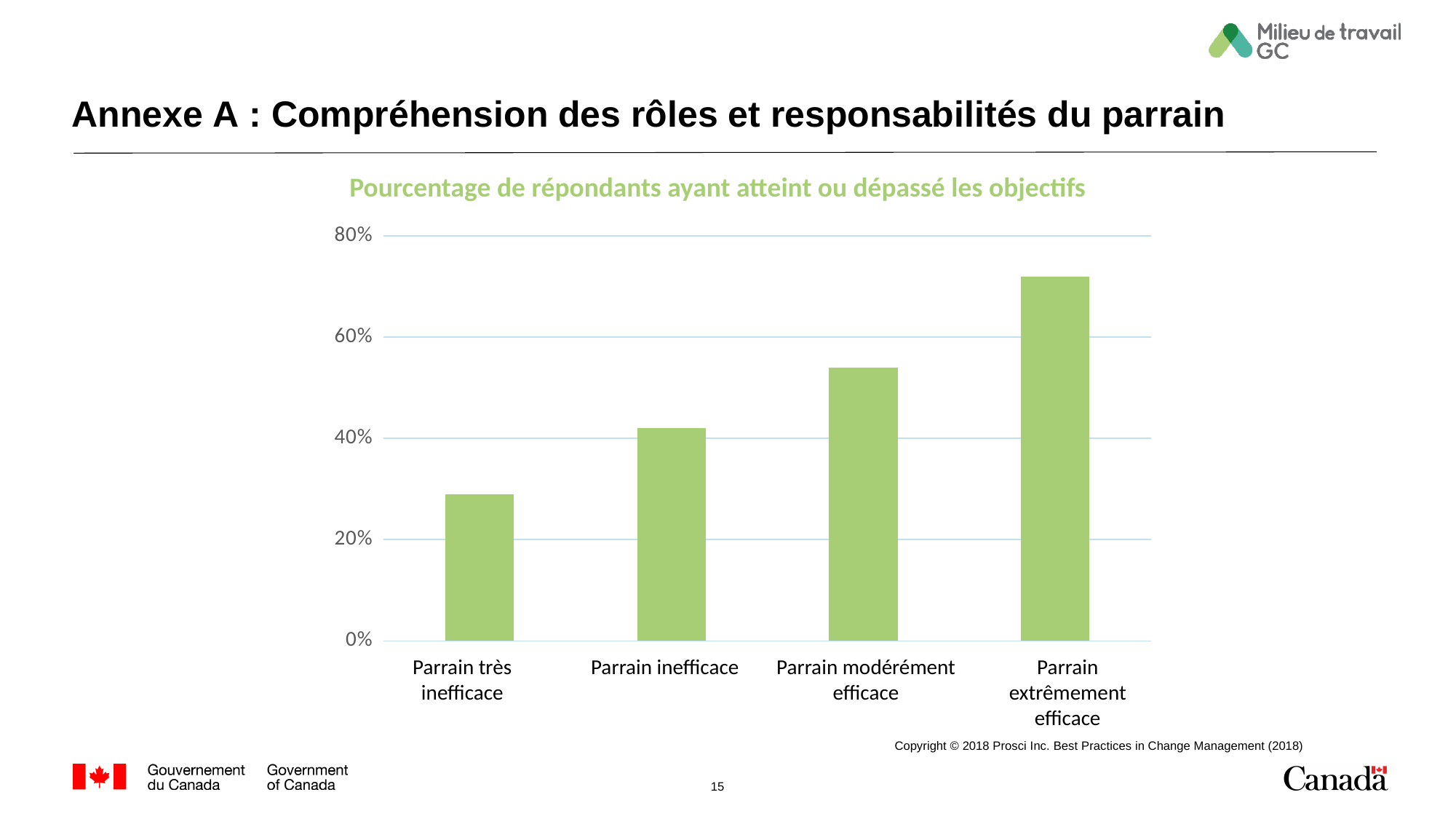
What is the title of the chart? Pourcentage de répondants ayant atteint ou dépassé les objectifs Is the value for Parrain très inefficace greater or less than 40%? less Is the value for Parrain modérément efficace greater or less than 60%? less Is the value for Parrain inefficace greater or less than 60%? less How many categories are shown on the x axis of the chart? 4 What kind of chart is shown on the slide? Bar chart Which is larger, the value for Parrain inefficace or the value for Parrain modérément efficace? Parrain modérément efficace Which category has the highest value? Parrain extrêmement efficace Do the values rise or fall from left to right along the x axis? Rise Which category has the lowest value? Parrain très inefficace